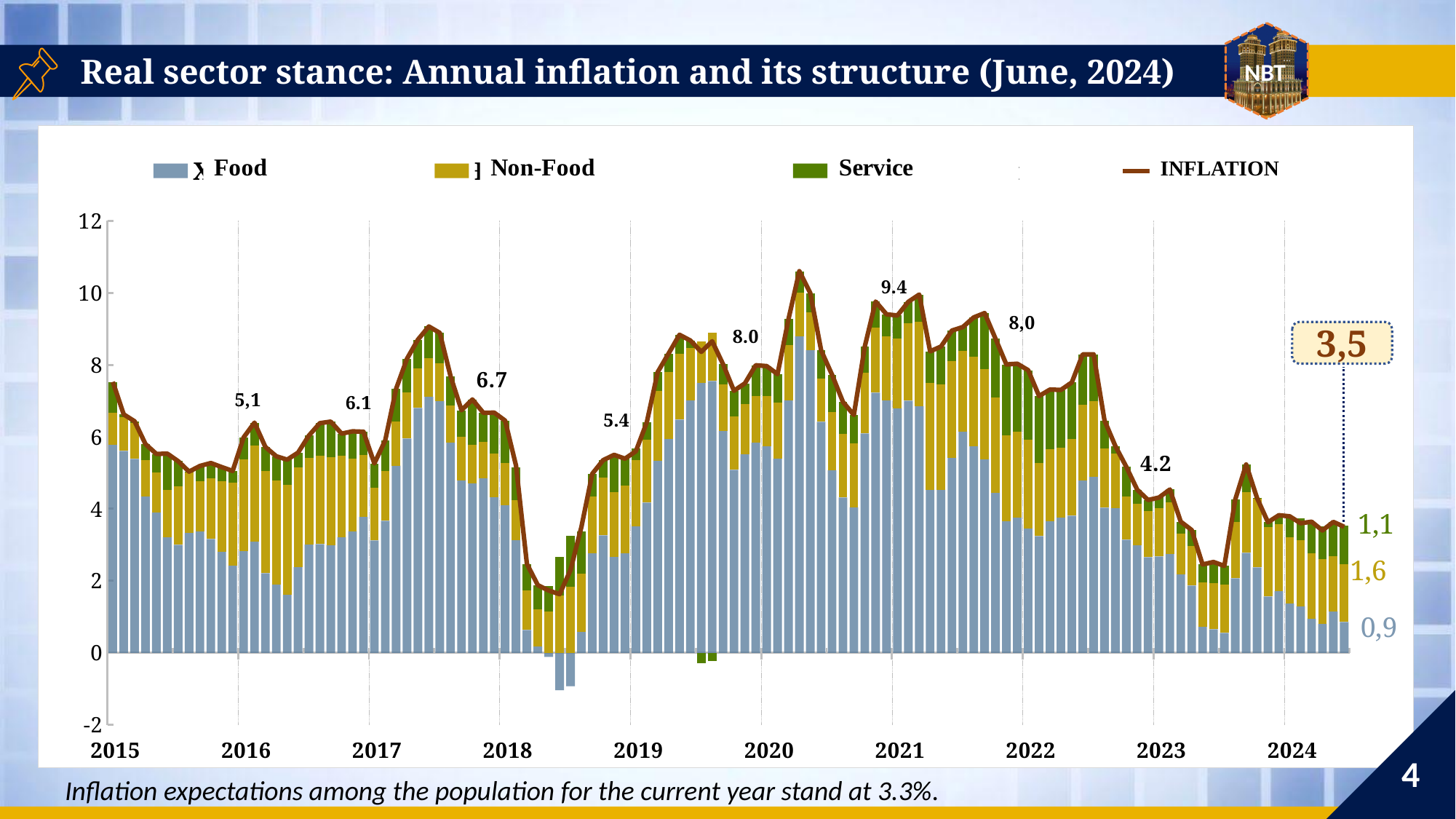
What is the Service contribution shown at the end of the chart (June 2024)? 1,1 What is the annual inflation value highlighted for June 2024? 3,5 What is the highest inflation value labelled on the INFLATION line? 9.4 What kind of chart is shown on the slide? stacked bar chart with a line Is the inflation value at the start of 2015 greater or less than 6? greater Which labelled inflation value is larger: the 2021 peak or the 2022 peak? 9.4 How many years are labelled on the x axis? 10 What is the Non-Food contribution shown at the end of the chart (June 2024)? 1,6 How many series does the legend list? 4 What is the difference between the labelled 2021 peak (9.4) and the labelled 2023 value (4.2)? 5.2 Does the INFLATION line rise or fall from the 2023 label (4.2) to the June 2024 value (3,5)? fall What is the Food contribution shown at the end of the chart (June 2024)? 0,9